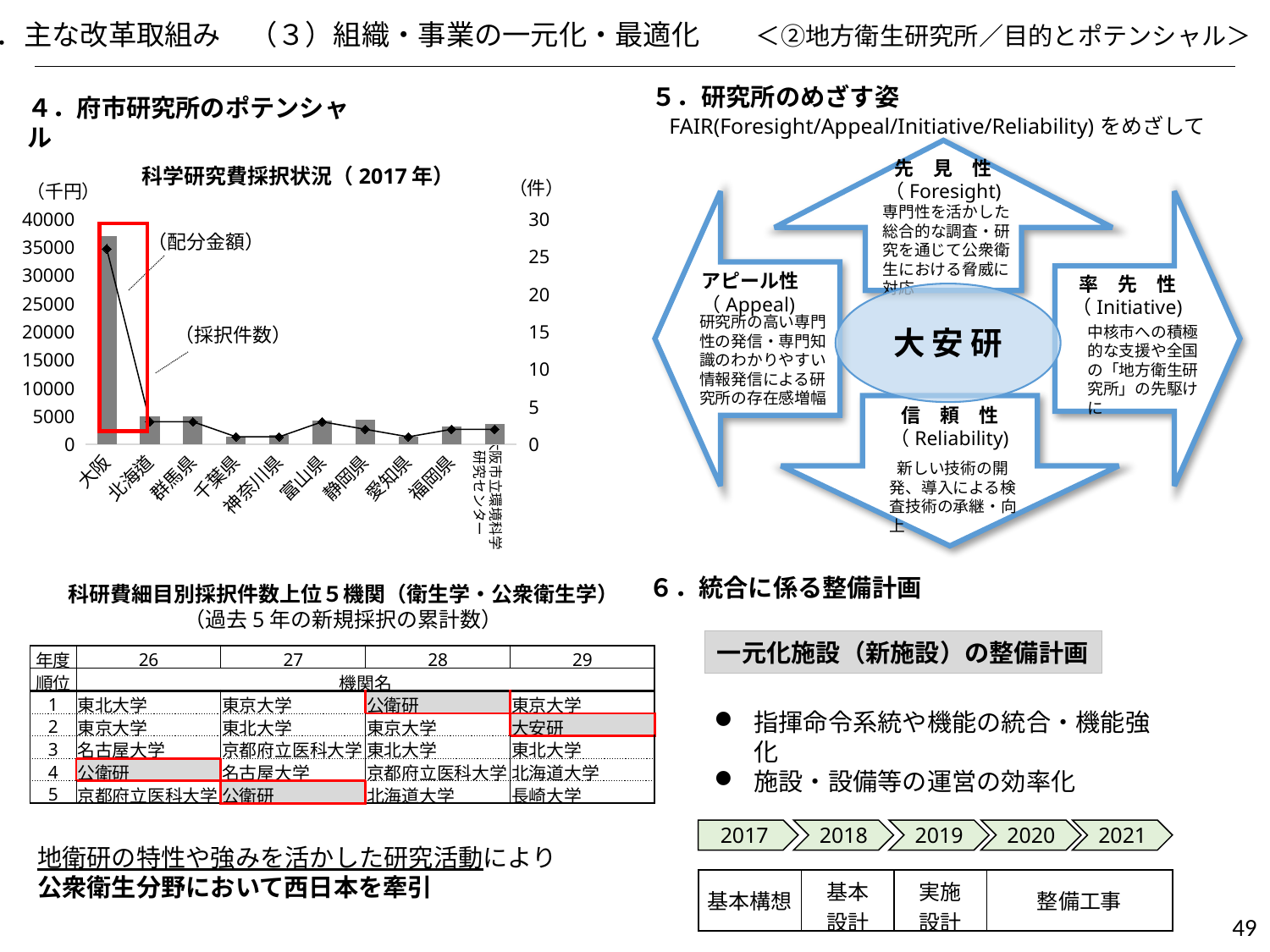
What unit is shown on the left axis of the 科学研究費採択状況（2017年） chart? 千円 Is the 採択件数 value for 北海道 greater or less than 10? less How many data series are plotted in the 科学研究費採択状況（2017年） chart? 2 Which category has the highest 採択件数 point in the 科学研究費採択状況（2017年） chart? 大阪 Is the 採択件数 value for 大阪 greater or less than 20? greater How many categories are shown on the x axis of the 科学研究費採択状況（2017年） chart? 10 What unit is shown on the right axis of the 科学研究費採択状況（2017年） chart? 件 Is the 配分金額 value for 北海道 greater or less than 10000? less Which has the larger 配分金額 bar, 大阪 or 北海道? 大阪 Which category has the highest 配分金額 bar in the 科学研究費採択状況（2017年） chart? 大阪 What kind of chart is 科学研究費採択状況（2017年）? A bar chart combined with a line chart